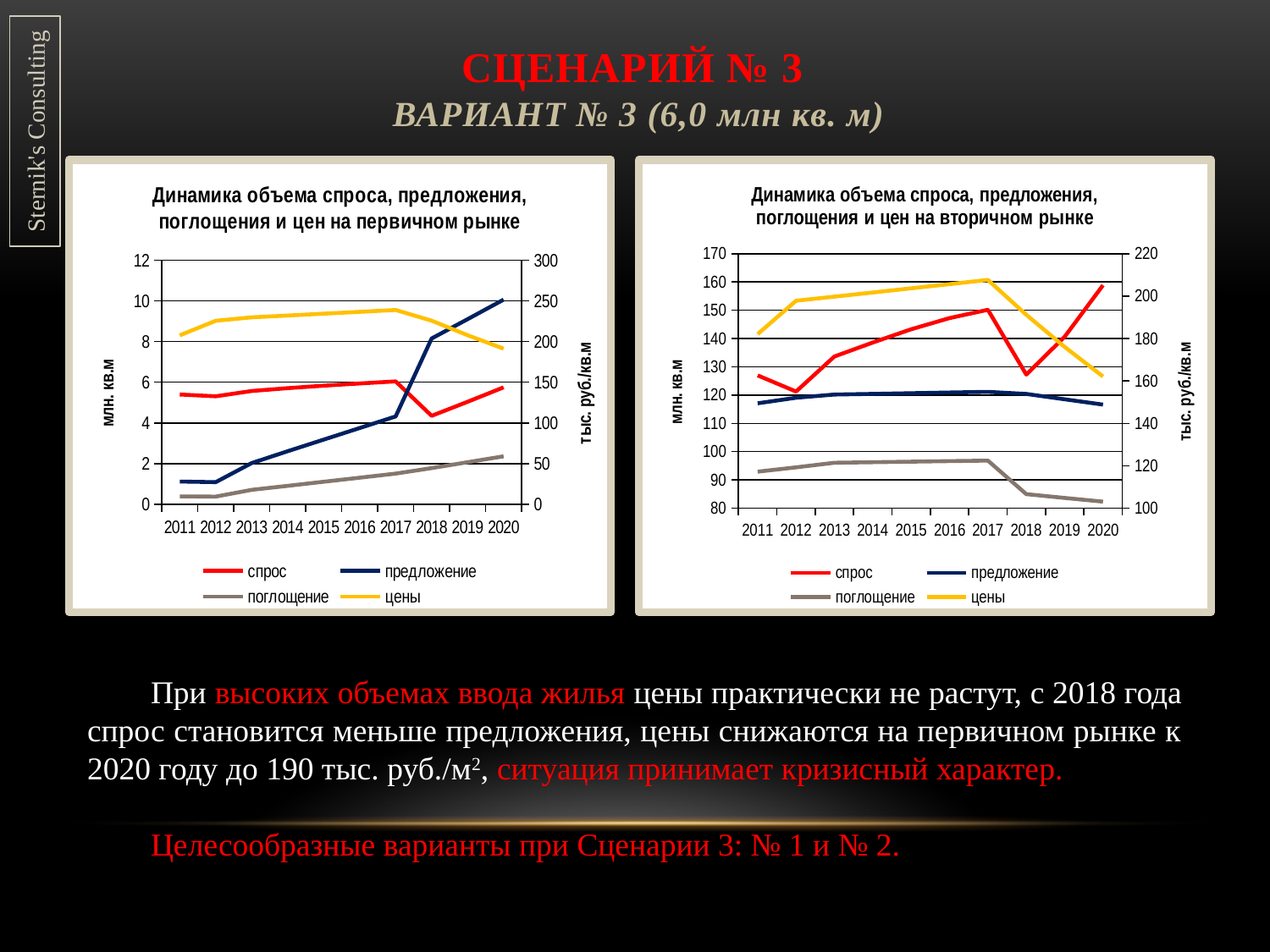
In the left chart ('...на первичном рынке'), is the value for 'поглощение' in 2011 greater or less than 2? less In the right chart ('...на вторичном рынке'), is the value for 'поглощение' in 2020 greater or less than 90? less How many series does the legend of the right chart ('...на вторичном рынке') list? 4 In the left chart ('...на первичном рынке'), is the value for 'цены' in 2017 greater or less than 200 on the right axis? greater In the right chart ('...на вторичном рынке'), in which year does the 'цены' line reach its highest value? 2017 In the left chart ('...на первичном рынке'), which is larger in 2020: 'спрос' or 'предложение'? предложение What kind of chart is the left chart, 'Динамика объема спроса, предложения, поглощения и цен на первичном рынке'? line chart What is the unit label on the right-hand vertical axis of the right chart ('...на вторичном рынке')? тыс. руб./кв.м How many years are shown on the x axis of the left chart ('...на первичном рынке')? 10 In the left chart ('...на первичном рынке'), does the 'предложение' line rise or fall from 2011 to 2020? rise